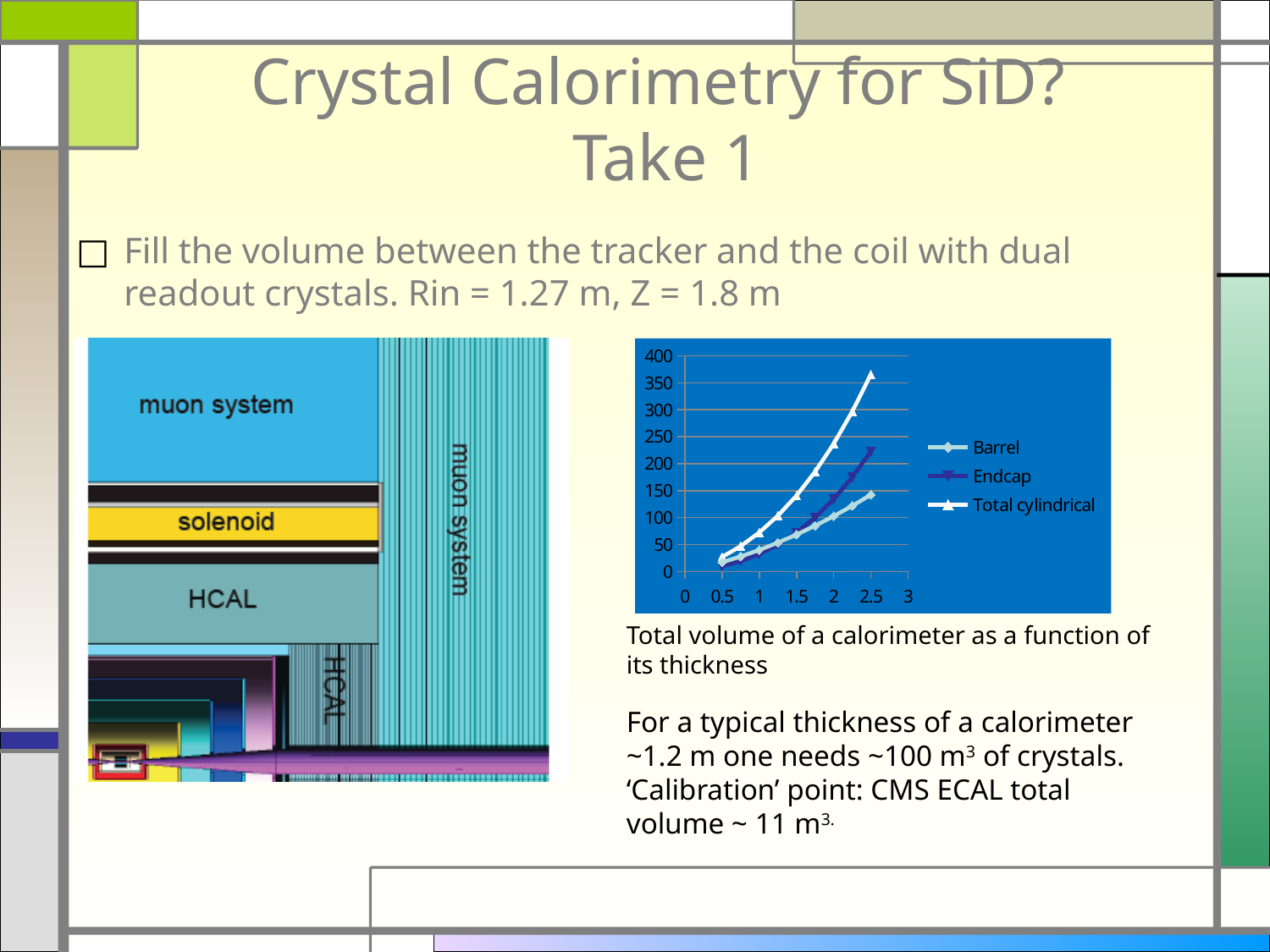
What are the three series named in the chart's legend? Barrel, Endcap, Total cylindrical What kind of chart is shown on the slide? line chart Do the values of the Total cylindrical series rise or fall as x increases? rise What is the highest tick value shown on the chart's y axis? 400 Which series reaches the highest value on the chart? Total cylindrical At x = 2.5, which is larger: the Endcap value or the Barrel value? Endcap Is the value of the Total cylindrical series at x = 2.5 greater or less than 300? greater Is the value of the Barrel series at x = 2.5 greater or less than 200? less Is the value of the Barrel series at x = 1 greater or less than 100? less Which series has the lowest value at x = 2.5? Barrel How many series does the chart's legend list? 3